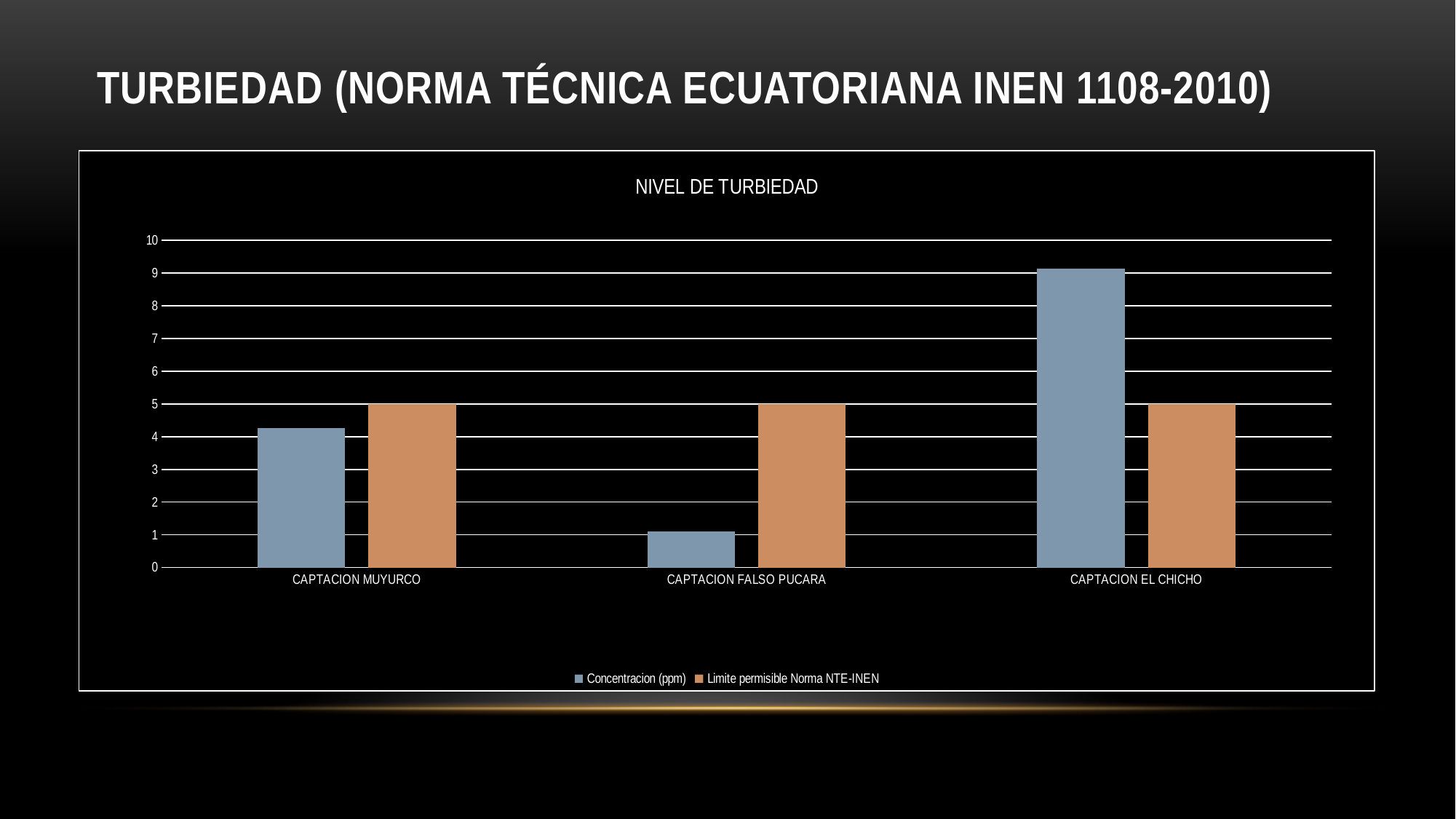
What is the value of Limite permisible Norma NTE-INEN for CAPTACION MUYURCO? 5 Which category has the lowest Concentracion (ppm)? CAPTACION FALSO PUCARA Is the Concentracion (ppm) value for CAPTACION FALSO PUCARA greater or less than 2? less What is the value of Limite permisible Norma NTE-INEN for CAPTACION EL CHICHO? 5 Which category has the highest Concentracion (ppm)? CAPTACION EL CHICHO Is the Concentracion (ppm) value for CAPTACION EL CHICHO greater or less than 8? greater What type of chart is shown on the slide? bar chart How many series does the chart legend list? 2 Which series is shown in orange in the chart? Limite permisible Norma NTE-INEN How many categories are shown on the x axis of the chart? 3 What is the title of the chart? NIVEL DE TURBIEDAD For CAPTACION MUYURCO, which is larger: Concentracion (ppm) or Limite permisible Norma NTE-INEN? Limite permisible Norma NTE-INEN